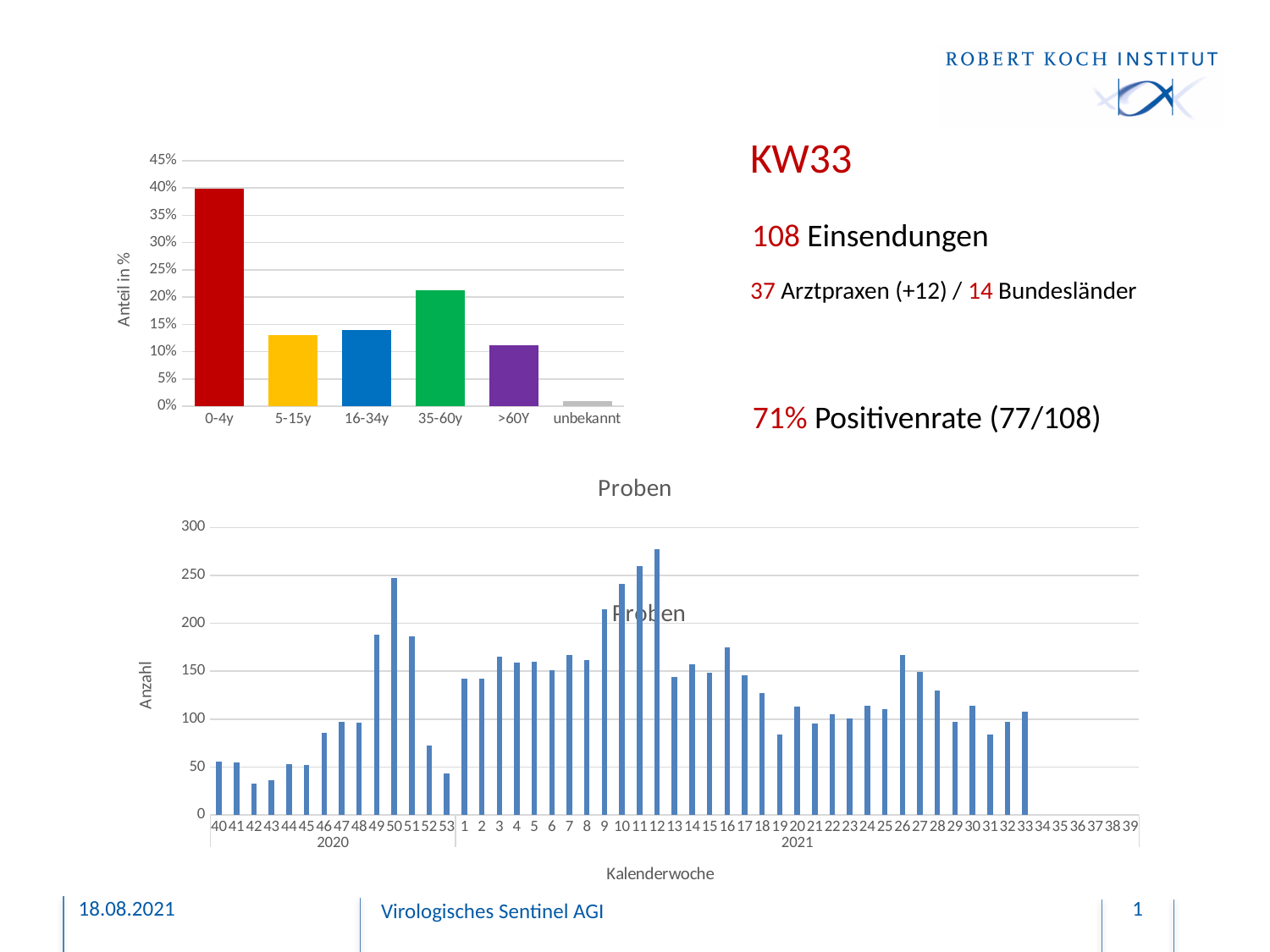
In the 'Proben' chart, is the value for week 50 of 2020 greater or less than 200? greater In the top-left chart (Anteil in %), which age group has the highest share? 0-4y What kind of chart is the 'Proben' chart at the bottom of the slide? bar chart In the 'Proben' chart, which calendar week has the highest value? 12 (2021) In the 'Proben' chart, is the value for week 42 of 2020 greater or less than 50? less What is the y-axis title of the 'Proben' chart? Anzahl How many categories are shown on the x axis of the top-left chart (Anteil in %)? 6 In the top-left chart (Anteil in %), is the value for 0-4y greater or less than 35%? greater In the top-left chart (Anteil in %), which is larger, the value for 35-60y or the value for 16-34y? 35-60y In the top-left chart (Anteil in %), which category has the lowest share? unbekannt